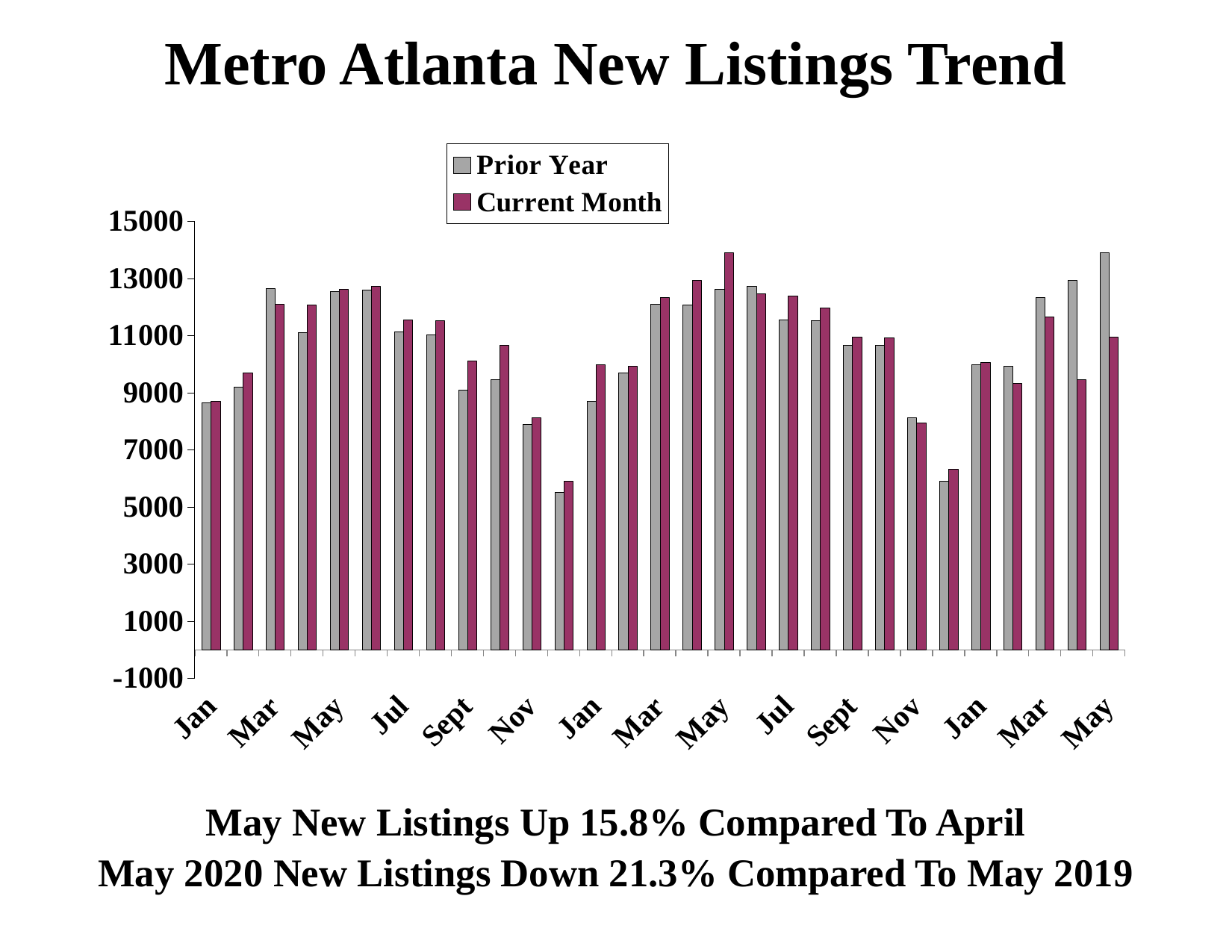
Do the Prior Year values rise or fall from the first Jan to the first Mar on the x axis? rise Is the Prior Year value for the first Dec (the bar just before the second Jan) greater or less than 7000? less For the last May on the x axis, which is larger: the Prior Year bar or the Current Month bar? Prior Year What are the two series named in the legend? Prior Year and Current Month What kind of chart is shown on the slide? bar chart Is the Current Month value for the first Jan on the x axis greater or less than 9000? less How many month labels are printed along the x axis? 15 What is the title of the chart? Metro Atlanta New Listings Trend Is the Current Month value for the middle May on the x axis greater or less than 13000? greater Which month has the highest Current Month bar? May (the middle May) How many series does the legend list? 2